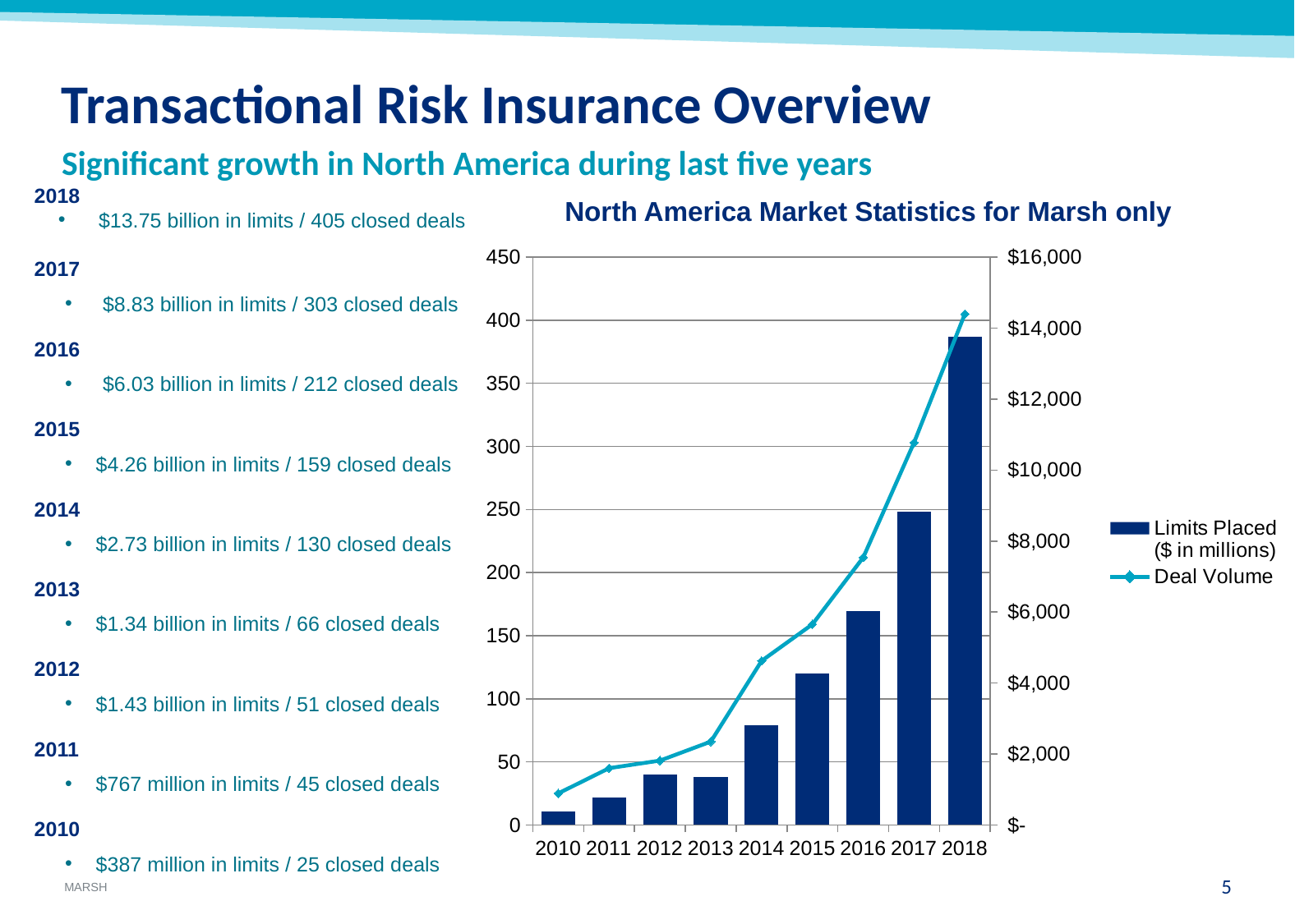
Does the Deal Volume line rise or fall from 2010 to 2018? rise Is the Limits Placed value for 2013 greater or less than $2,000? less Which year has the larger Deal Volume, 2012 or 2013? 2013 Which series is shown as bars in the chart? Limits Placed ($ in millions) What is the title of the chart? North America Market Statistics for Marsh only Is the Limits Placed value for 2018 greater or less than $12,000? greater Which year has the highest Limits Placed bar? 2018 Which year has the lowest Deal Volume? 2010 Is the Deal Volume for 2016 greater or less than 200? greater How many years are shown on the x axis of the chart? 9 How many series does the chart legend list? 2